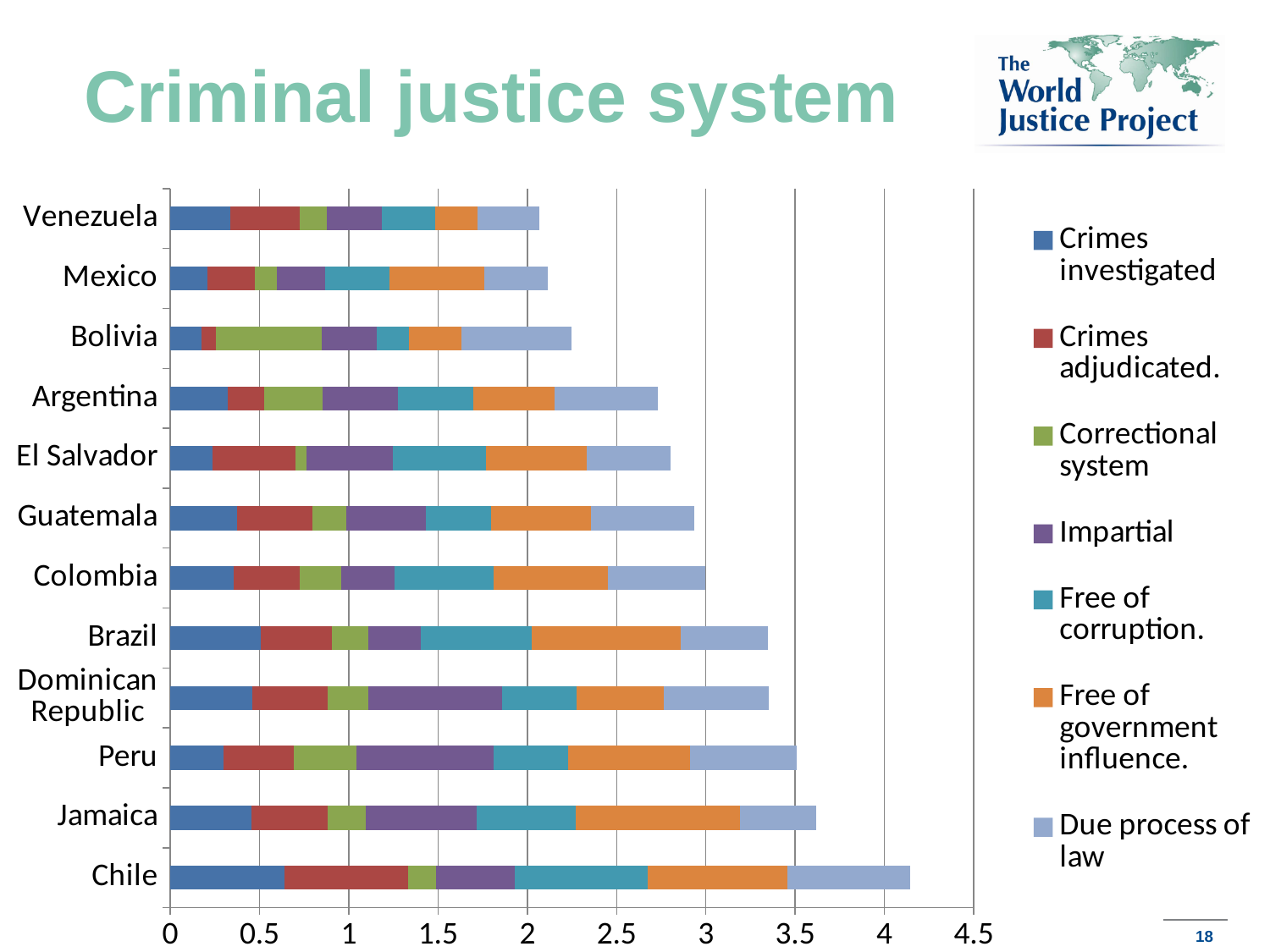
Is the total bar for Bolivia greater or less than 2? greater How many countries are listed on the chart? 12 What is the title of the slide? Criminal justice system What kind of chart is shown on the slide? Stacked bar chart Which country has the shortest total bar? Venezuela How many series does the legend list? 7 What is the last entry in the legend? Due process of law Which country has the longer total bar, Jamaica or Brazil? Jamaica Is the total bar for Argentina greater or less than 3? less Is the total bar for Chile greater or less than 4? greater Which country has the longest total bar? Chile